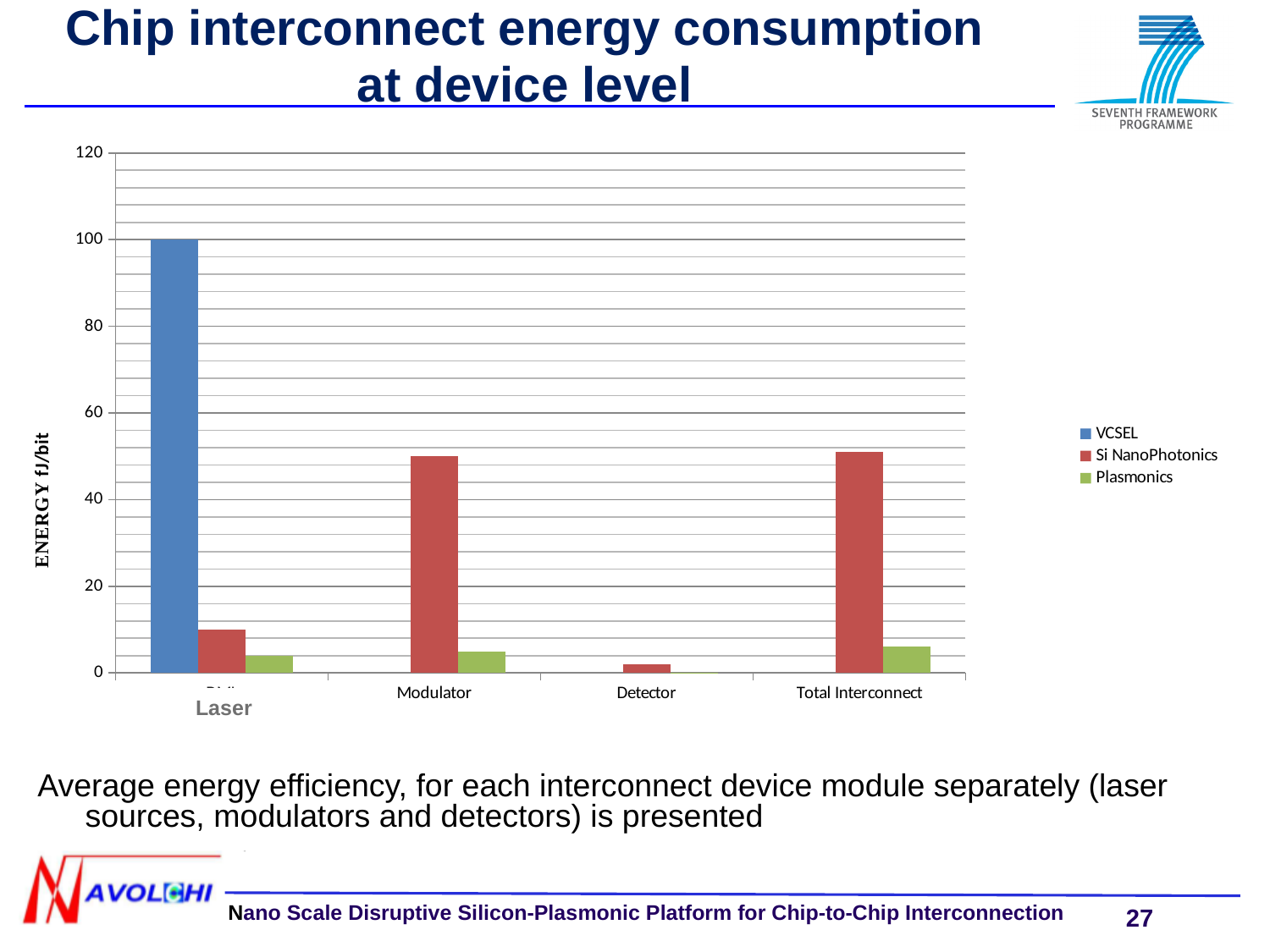
How many categories are shown along the x axis? 4 Is the Si NanoPhotonics value for Total Interconnect greater or less than 60? less Is the Plasmonics value for Modulator greater or less than 20? less For the Laser category, which is larger: the VCSEL value or the Si NanoPhotonics value? VCSEL What is the VCSEL energy value for the Laser category? 100 Is the Si NanoPhotonics value for Modulator greater or less than 40? greater For the Modulator category, which series has the highest value? Si NanoPhotonics What is the label on the y axis of the chart? ENERGY fJ/bit For the Laser category, which series has the lowest value? Plasmonics How many series does the legend list? 3 What kind of chart is shown on the slide? bar chart